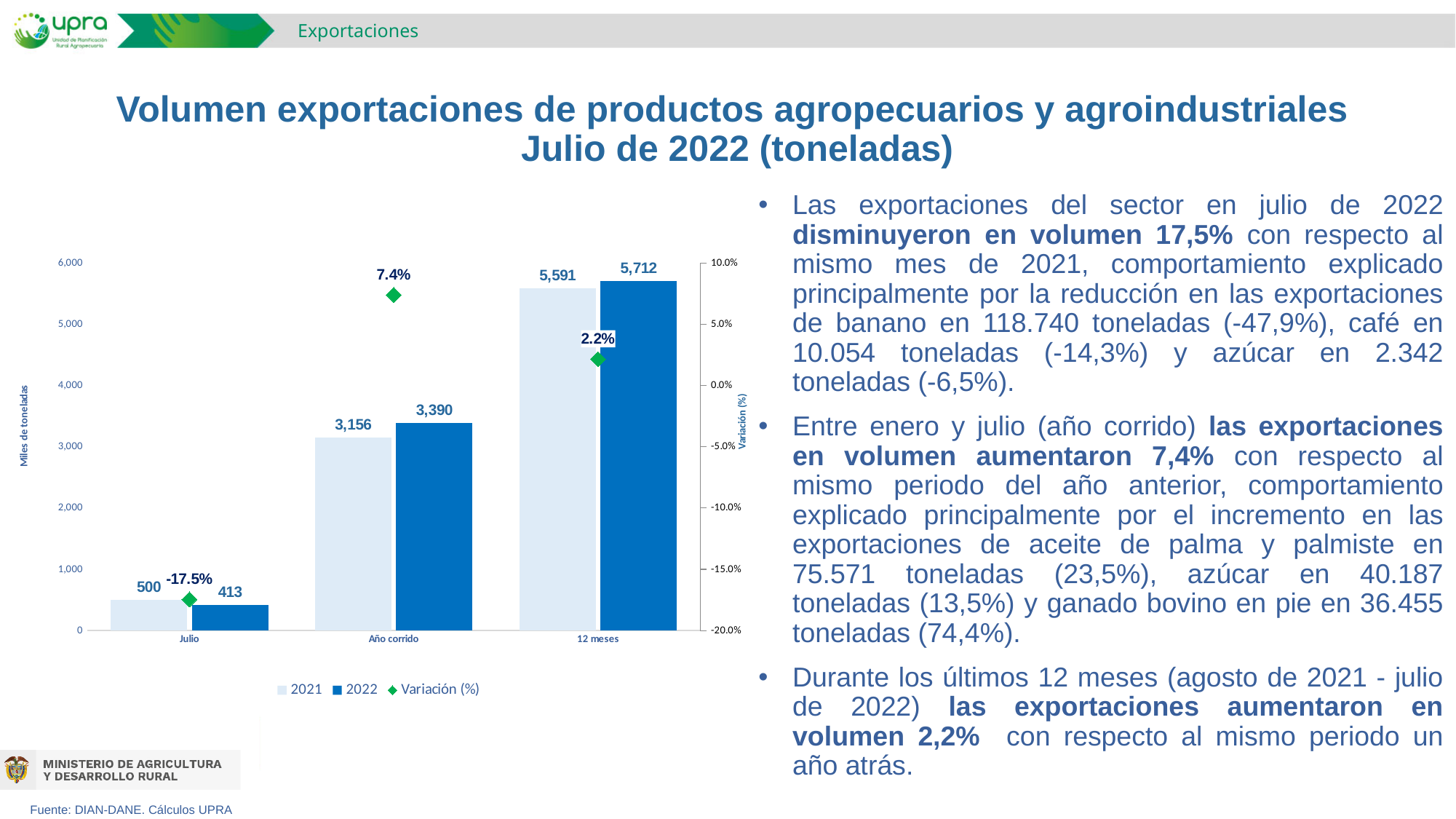
Which is larger for Julio, the 2021 value or the 2022 value? 2021 What is the Variación (%) value for Julio? -17.5% What kind of chart is this? Bar chart with a line/marker series What is the Variación (%) value for 12 meses? 2.2% What is the 2022 value for Julio? 413 How many series does the legend list? 3 Which category has the lowest 2021 value? Julio What is the difference between the 2022 and 2021 values for 12 meses? 121 Which category has the highest 2022 value? 12 meses What is the label of the left vertical axis? Miles de toneladas How many categories are shown on the x axis? 3 What is the 2021 value for Año corrido? 3,156